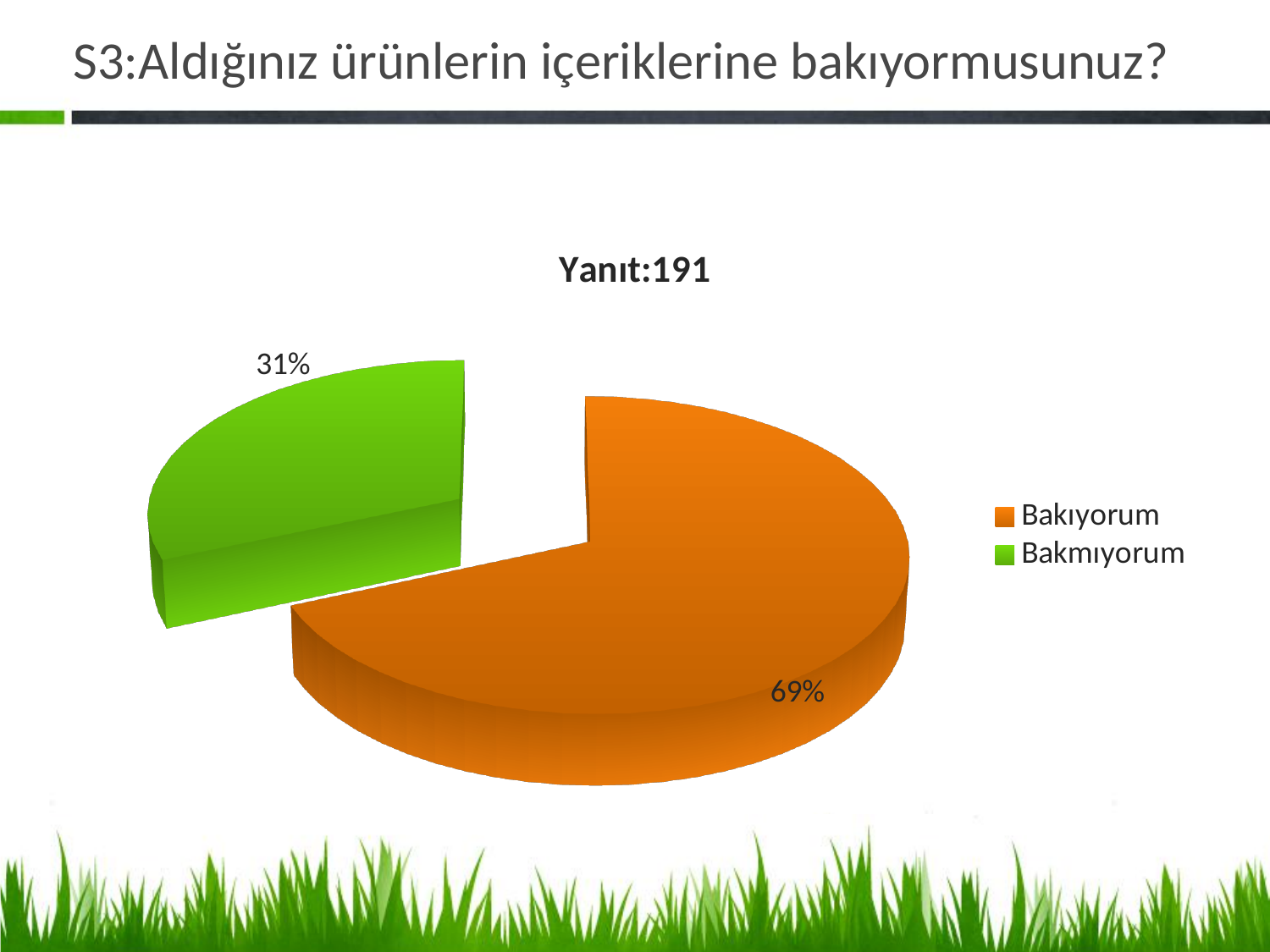
What is the difference in percentage points between Bakıyorum and Bakmıyorum? 38 What share of the pie does the Bakıyorum slice represent? 69% What percentage is shown for Bakıyorum? 69% How many entries does the legend list? 2 What colour is the Bakmıyorum slice? green What percentage is shown for Bakmıyorum? 31% How many categories does the pie chart have? 2 What kind of chart is shown on the slide? pie chart Which is larger, the share for Bakıyorum or the share for Bakmıyorum? Bakıyorum What is the chart's title? Yanıt:191 Which category has the smallest share of the pie? Bakmıyorum Which category has the largest share of the pie? Bakıyorum